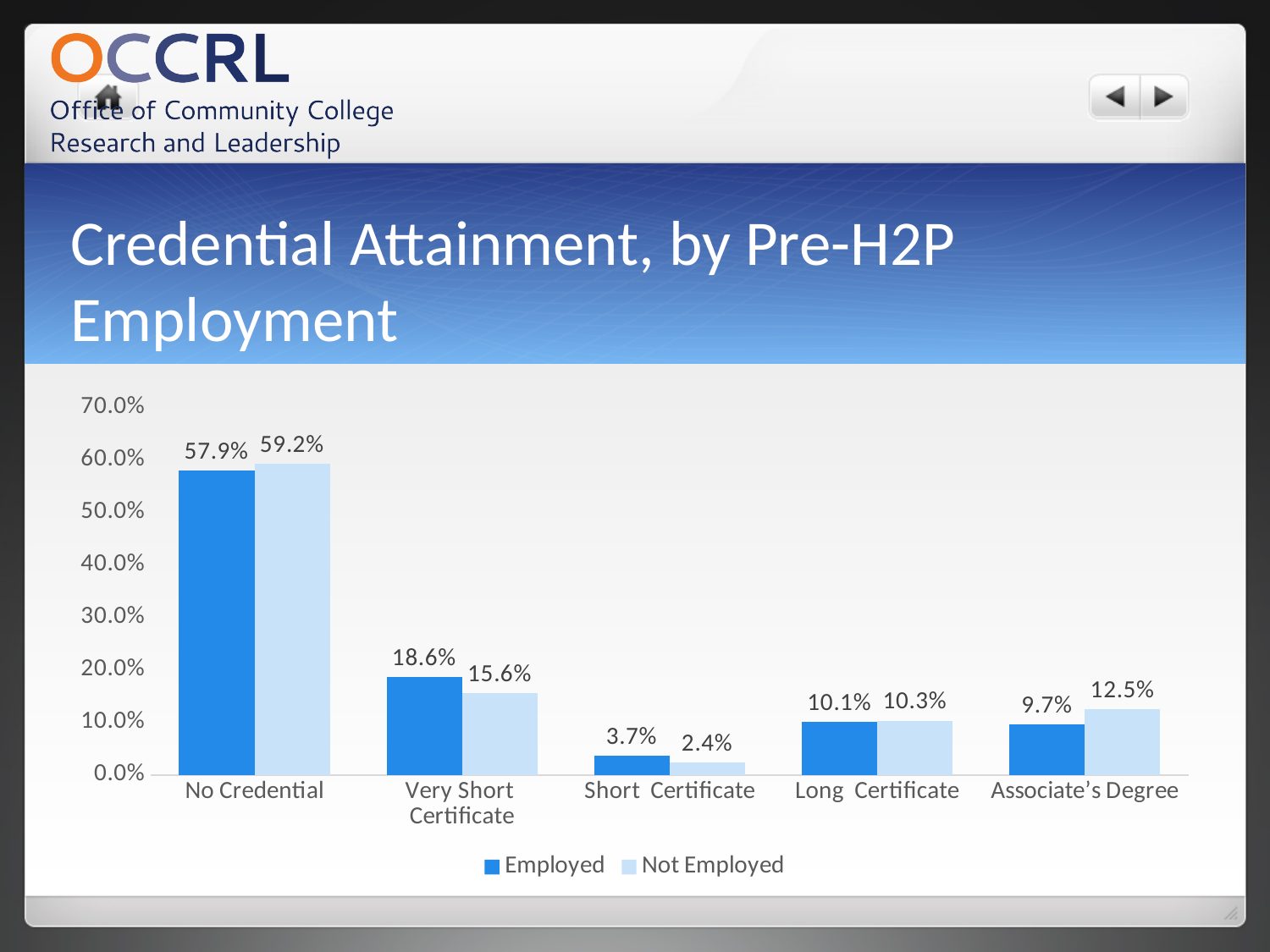
Which is larger for Very Short Certificate: the Employed value or the Not Employed value? Employed What is the Employed value for Short Certificate? 3.7% What kind of chart is shown on the slide? Bar chart How many credential categories are shown on the x axis? 5 What is the difference between the Not Employed and Employed values for No Credential? 1.3% Which category has the highest Not Employed value? No Credential Which category has the lowest Employed value? Short Certificate What is the Not Employed value for Very Short Certificate? 15.6% What is the Employed value for No Credential? 57.9% What is the Not Employed value for Associate's Degree? 12.5% How many series does the legend list? 2 What is the title of the slide? Credential Attainment, by Pre-H2P Employment